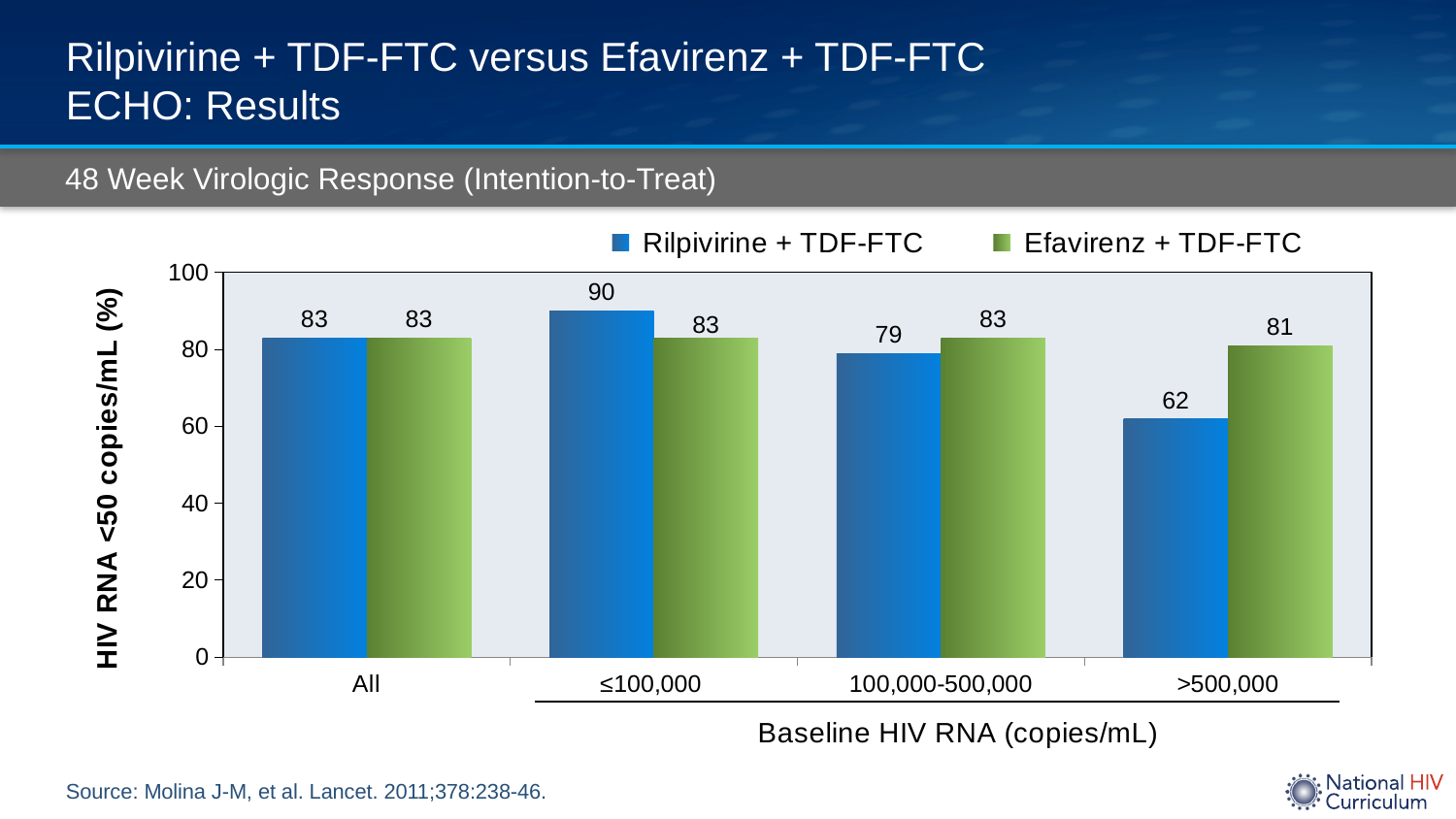
Which category has the highest value for Rilpivirine + TDF-FTC? ≤100,000 Which category has the lowest value for Rilpivirine + TDF-FTC? >500,000 In the ≤100,000 category, which series has the larger value? Rilpivirine + TDF-FTC What is the value for Rilpivirine + TDF-FTC in the ≤100,000 category? 90 What is the value for Efavirenz + TDF-FTC in the 100,000-500,000 category? 83 How many categories are shown on the x axis? 4 Is the value for Rilpivirine + TDF-FTC in the >500,000 category greater or less than 80? less What kind of chart is shown on the slide? bar chart What is the y-axis label of the chart? HIV RNA <50 copies/mL (%) What is the difference between Efavirenz + TDF-FTC and Rilpivirine + TDF-FTC in the >500,000 category? 19 What is the value for Rilpivirine + TDF-FTC in the >500,000 category? 62 How many series does the legend list? 2